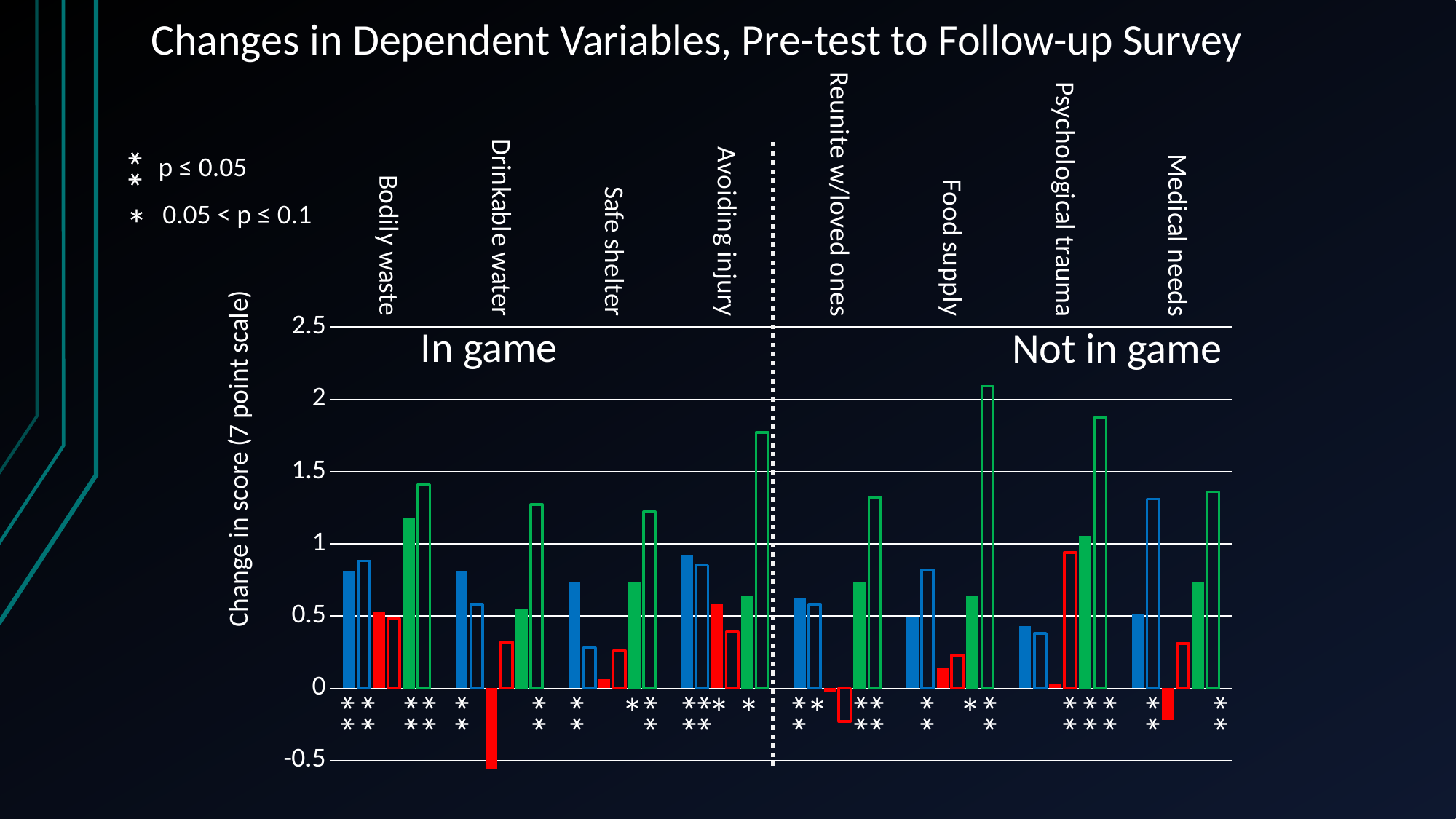
What is the title of the chart? Changes in Dependent Variables, Pre-test to Follow-up Survey Is the tallest bar for Bodily waste greater or less than 1.5? less How many categories are in the 'In game' group of the chart? 4 What is the label on the vertical axis of the chart? Change in score (7 point scale) Is the tallest bar for Psychological trauma greater or less than 2? less Which category contains the tallest bar in the chart? Food supply Which category contains the lowest (most negative) bar in the chart? Drinkable water Is the lowest bar for Drinkable water greater or less than 0? less How many categories (dependent variables) are shown along the x axis of the chart? 8 What kind of chart is shown on the slide? bar chart